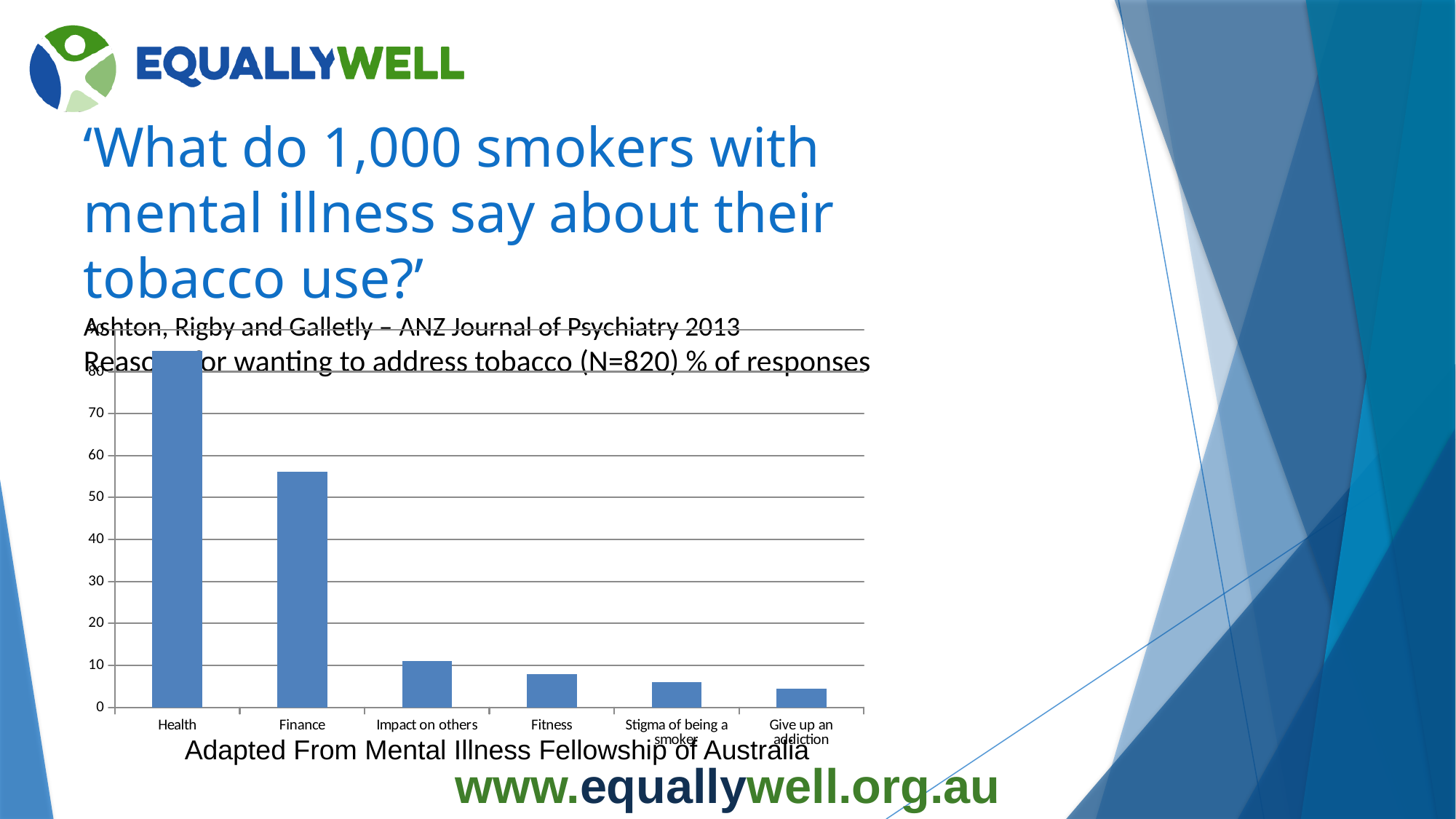
Which category has the lowest value in the chart? Give up an addiction Which is larger, the value for Finance or the value for Impact on others? Finance What is the highest value shown on the chart's vertical axis? 80 Which category has the highest value in the chart? Health Which is larger, the value for Fitness or the value for Stigma of being a smoker? Fitness What kind of chart is shown on the slide? bar chart Is the value for Health greater or less than 80? greater Is the value for Finance greater or less than 50? greater How many categories are shown on the x axis of the chart? 6 Do the values rise or fall moving from left to right along the x axis? fall Is the value for Fitness greater or less than 10? less